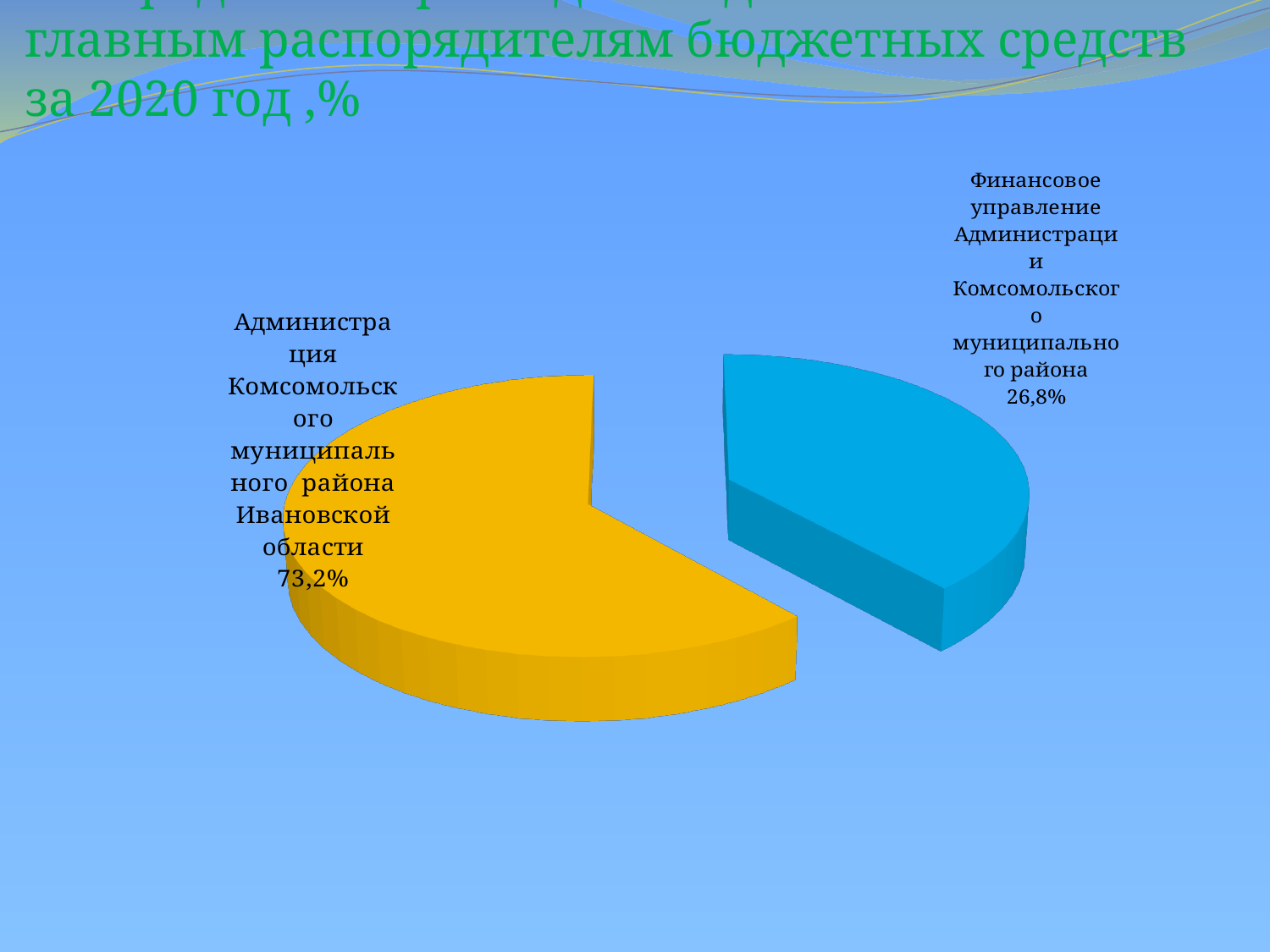
What share of the pie is labelled for Администрация Комсомольского муниципального района Ивановской области? 73,2% Which is larger: the share of Администрация Комсомольского муниципального района Ивановской области or the share of Финансовое управление Администрации Комсомольского муниципального района? Администрация Комсомольского муниципального района Ивановской области How many slices does the pie chart have? 2 Is the share of Финансовое управление Администрации Комсомольского муниципального района greater or less than 50%? less Which category has the largest share of the pie? Администрация Комсомольского муниципального района Ивановской области What colour is the slice for Финансовое управление Администрации Комсомольского муниципального района? Blue What colour is the slice for Администрация Комсомольского муниципального района Ивановской области? Yellow What is the difference in percentage points between the share of Администрация Комсомольского муниципального района Ивановской области and the share of Финансовое управление Администрации Комсомольского муниципального района? 46,4 What is the total of the two slice percentages shown on the pie chart? 100% Which category has the smallest share of the pie? Финансовое управление Администрации Комсомольского муниципального района What kind of chart is shown on the slide? Pie chart What share of the pie is labelled for Финансовое управление Администрации Комсомольского муниципального района? 26,8%